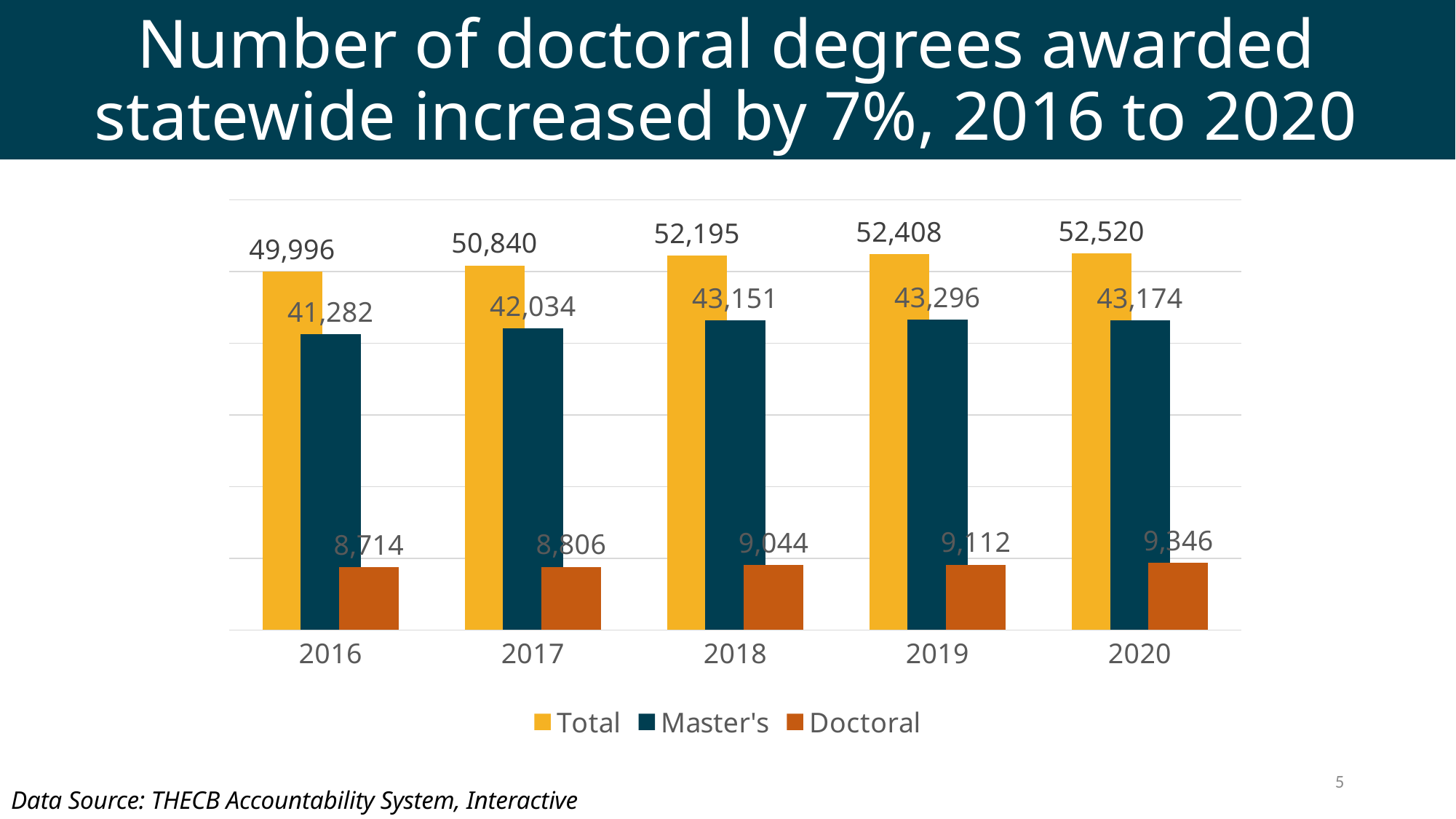
What is the difference between the Doctoral values for 2019 and 2018? 68 Which year has the lowest Doctoral value? 2016 Which year has the highest Master's value? 2019 What is the difference between the Total values for 2020 and 2016? 2,524 How many series does the legend list? 3 How many years are shown on the x axis? 5 What is the Total value for 2018? 52,195 What is the Doctoral value for 2020? 9,346 Which year has the highest Total value? 2020 What kind of chart is shown on the slide? bar chart Is the Master's value for 2019 larger or smaller than the Master's value for 2020? larger What is the Master's value for 2016? 41,282